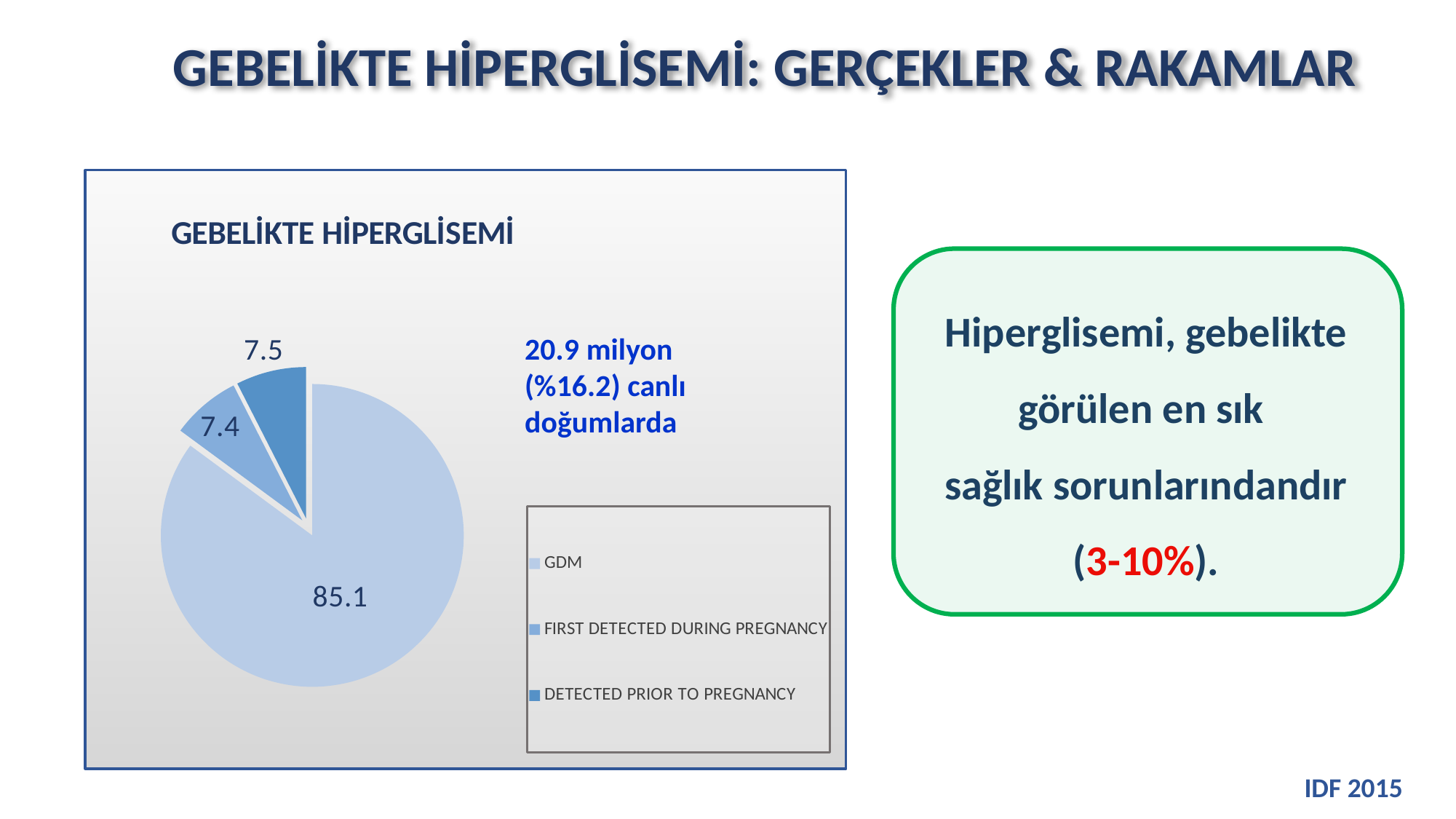
What is the title of the chart on the slide? GEBELİKTE HİPERGLİSEMİ Which category has the largest slice of the pie chart? GDM What is the difference between the GDM value and the DETECTED PRIOR TO PREGNANCY value? 77.6 What kind of chart is shown on the slide? Pie chart What is the value shown for the FIRST DETECTED DURING PREGNANCY slice? 7.4 Which is larger: the GDM slice or the FIRST DETECTED DURING PREGNANCY slice? GDM What is the value shown for the DETECTED PRIOR TO PREGNANCY slice? 7.5 What is the value shown for the GDM slice of the pie chart? 85.1 Which category has the smallest slice of the pie chart? FIRST DETECTED DURING PREGNANCY How many slices does the pie chart have? 3 How many entries does the legend of the pie chart list? 3 What is the difference between the DETECTED PRIOR TO PREGNANCY value and the FIRST DETECTED DURING PREGNANCY value? 0.1